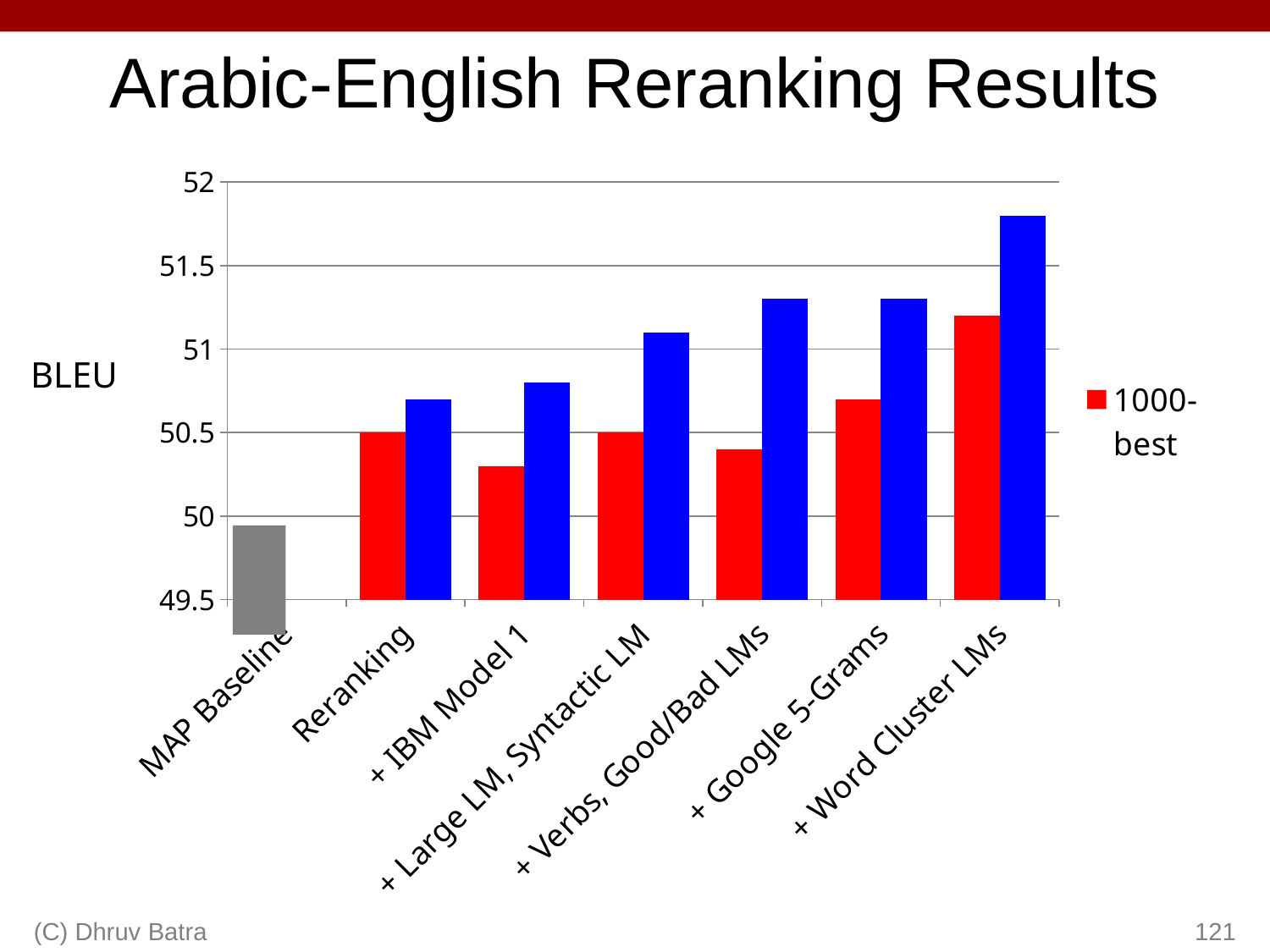
Is the red (1000-best) value for + Word Cluster LMs greater or less than 51? greater For + Google 5-Grams, which bar is taller, the red (1000-best) bar or the blue bar? the blue bar Which category has the tallest red (1000-best) bar? + Word Cluster LMs Is the blue value for + Word Cluster LMs greater or less than 51.5? greater Do the blue bars generally rise or fall from Reranking to + Word Cluster LMs? rise How many series does the legend list? 1 Which category has the tallest blue bar? + Word Cluster LMs What is the entry shown in the legend? 1000-best How many categories are shown along the x axis? 7 What kind of chart is shown on the slide? bar chart What is the label of the y axis? BLEU Is the red (1000-best) value for + IBM Model 1 greater or less than 50.5? less